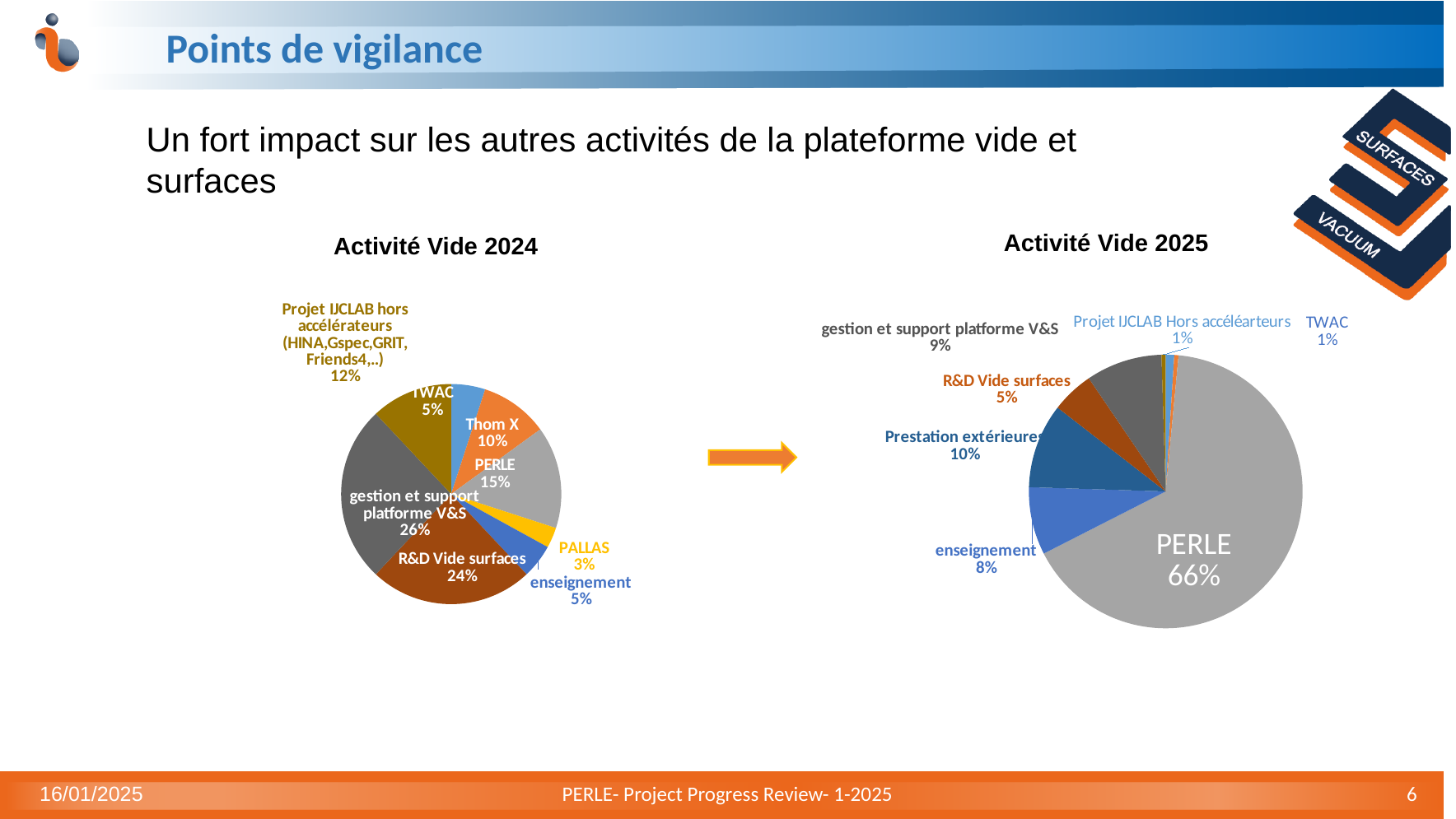
By how many percentage points did PERLE's share increase from the 'Activité Vide 2024' chart to the 'Activité Vide 2025' chart? 51 How many slices does the 'Activité Vide 2024' chart have? 8 How many slices does the 'Activité Vide 2025' chart have? 8 In the 'Activité Vide 2025' chart, what share does PERLE have? 66% In the 'Activité Vide 2024' chart, what share does PERLE have? 15% In the 'Activité Vide 2024' chart, which category has the largest share? gestion et support platforme V&S In the 'Activité Vide 2024' chart, which is larger: Thom X or TWAC? Thom X In the 'Activité Vide 2024' chart, what is the share of R&D Vide surfaces? 24% What type of chart is 'Activité Vide 2025'? Pie chart In the 'Activité Vide 2025' chart, which category has the largest share? PERLE In the 'Activité Vide 2024' chart, which category has the smallest share? PALLAS In the 'Activité Vide 2025' chart, what is the share of Prestation extérieure? 10%